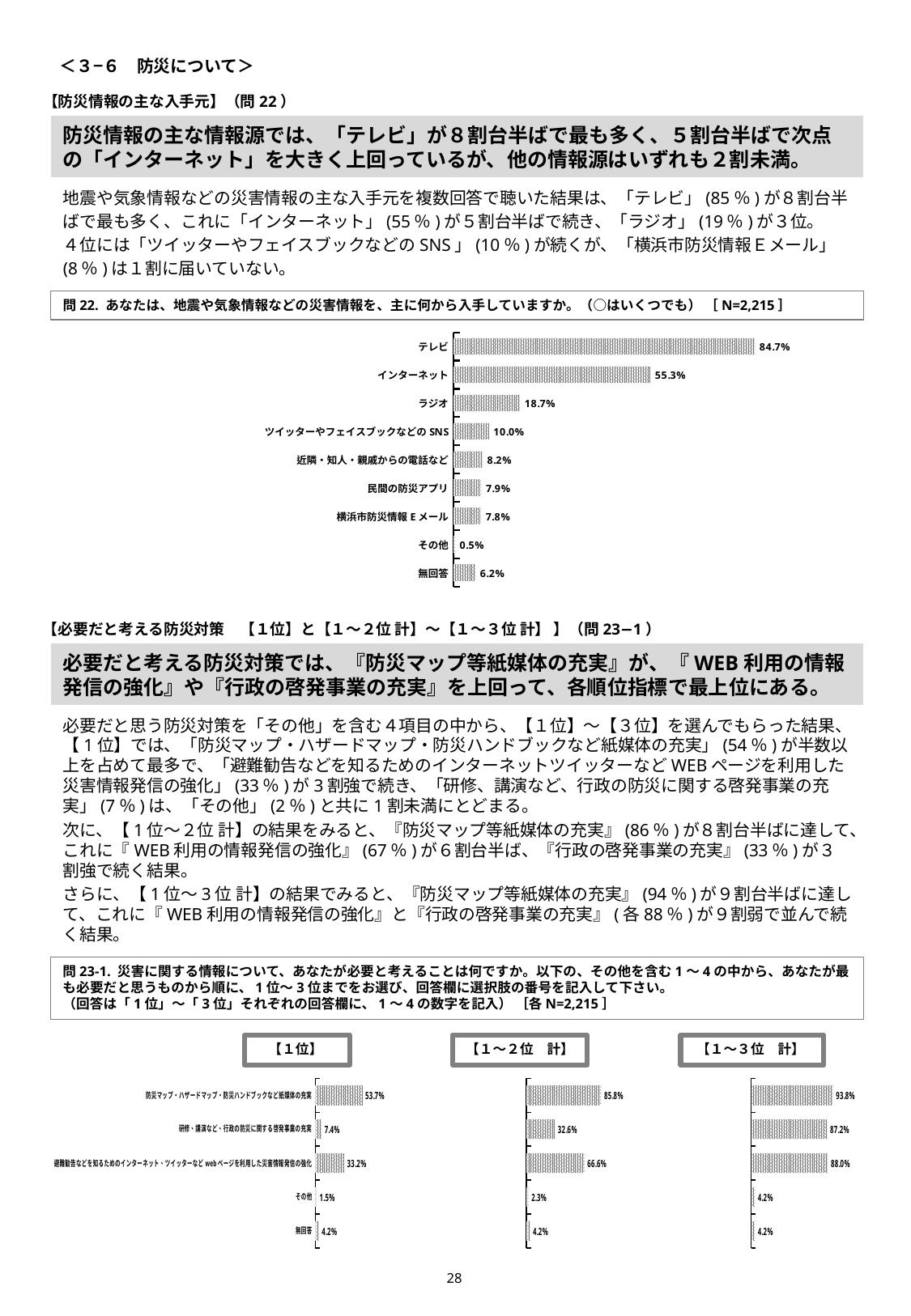
In the 問22 chart (top), what is the value for ラジオ? 18.7% In the 【1～3位 計】 chart of 問23-1, which category has the highest value? 防災マップ・ハザードマップ・防災ハンドブックなど紙媒体の充実 In the 【1位】 chart of 問23-1, what is the value for 防災マップ・ハザードマップ・防災ハンドブックなど紙媒体の充実? 53.7% How many categories are shown in the 問22 chart (top)? 9 In the 【1～2位 計】 chart of 問23-1, what is the value for 避難勧告などを知るためのインターネット、ツイッターなどwebページを利用した災害情報発信の強化? 66.6% In the 問22 chart (top), which category has the lowest value? その他 In the 【1位】 chart of 問23-1, what is the value for 無回答? 4.2% In the 【1～3位 計】 chart of 問23-1, what is the difference between 避難勧告などを知るためのインターネット、ツイッターなどwebページを利用した災害情報発信の強化 and 研修、講演など、行政の防災に関する啓発事業の充実? 0.8% In the 問22 chart (top), what is the difference between テレビ and インターネット? 29.4% What type of chart is the 問22 chart (top)? bar chart In the 問22 chart (top), what is the value for テレビ? 84.7% In the 問22 chart (top), which is larger: 民間の防災アプリ or 近隣・知人・親戚からの電話など? 近隣・知人・親戚からの電話など